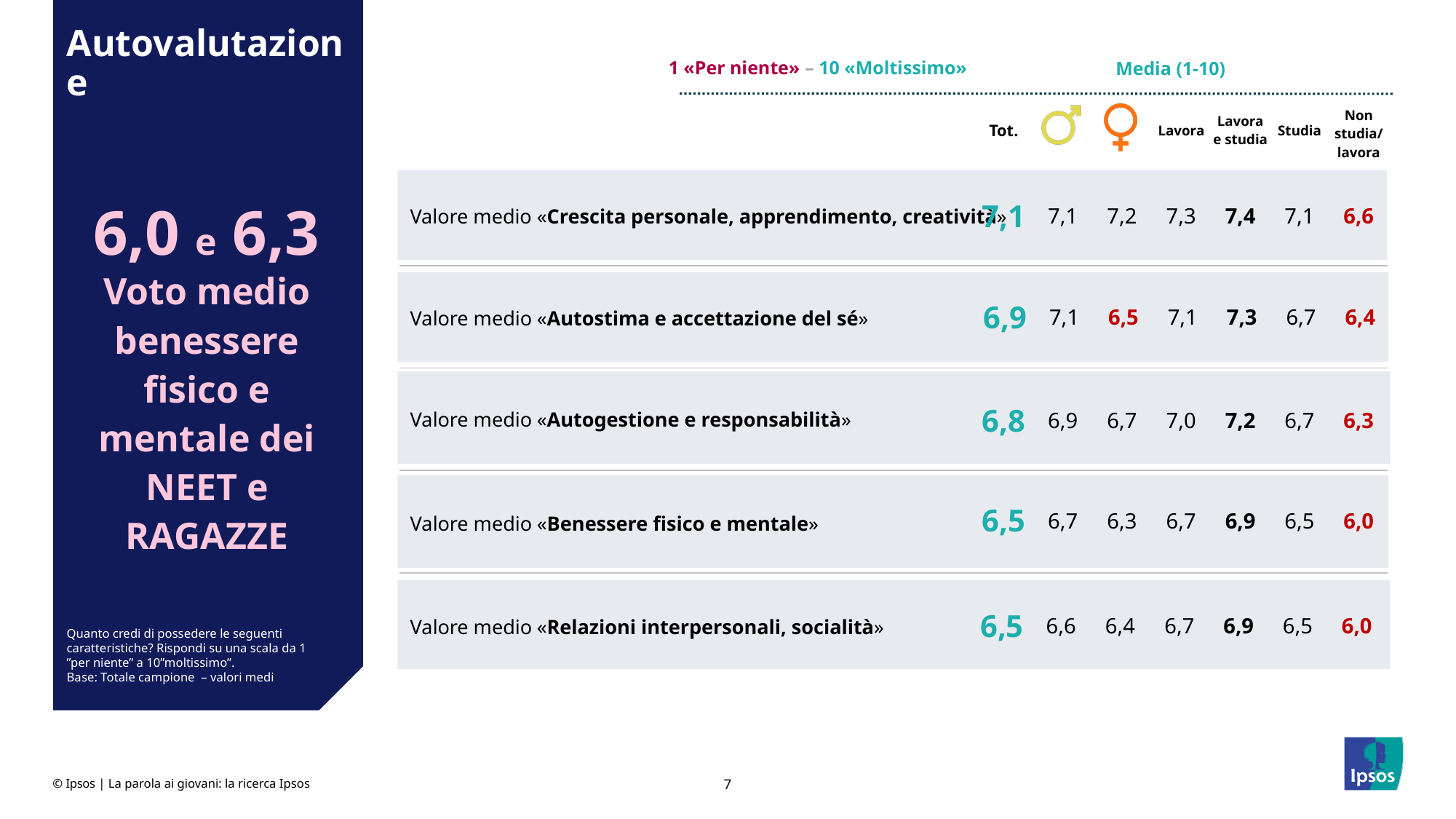
For «Benessere fisico e mentale», which is larger: the male value or the female value? Male (6,7) Which characteristic has the highest total (Tot.) mean value? Crescita personale, apprendimento, creatività What is the difference between the 'Lavora e studia' and 'Non studia/lavora' mean values for «Relazioni interpersonali, socialità»? 0,9 What is the mean value for «Benessere fisico e mentale» in the 'Non studia/lavora' column? 6,0 What scale range is indicated above the table? 1 «Per niente» – 10 «Moltissimo» How many characteristics (rows) are listed in the table? 5 How many data columns does the table have (Tot., male, female, Lavora, Lavora e studia, Studia, Non studia/lavora)? 7 What is the mean value for «Crescita personale, apprendimento, creatività» in the 'Lavora e studia' column? 7,4 Which column has the lowest mean value for «Autostima e accettazione del sé»? Non studia/lavora What is the total (Tot.) mean value for «Autostima e accettazione del sé»? 6,9 What is the mean value for «Autogestione e responsabilità» in the 'Lavora' column? 7,0 What kind of visual is used to present the data on this slide? Table